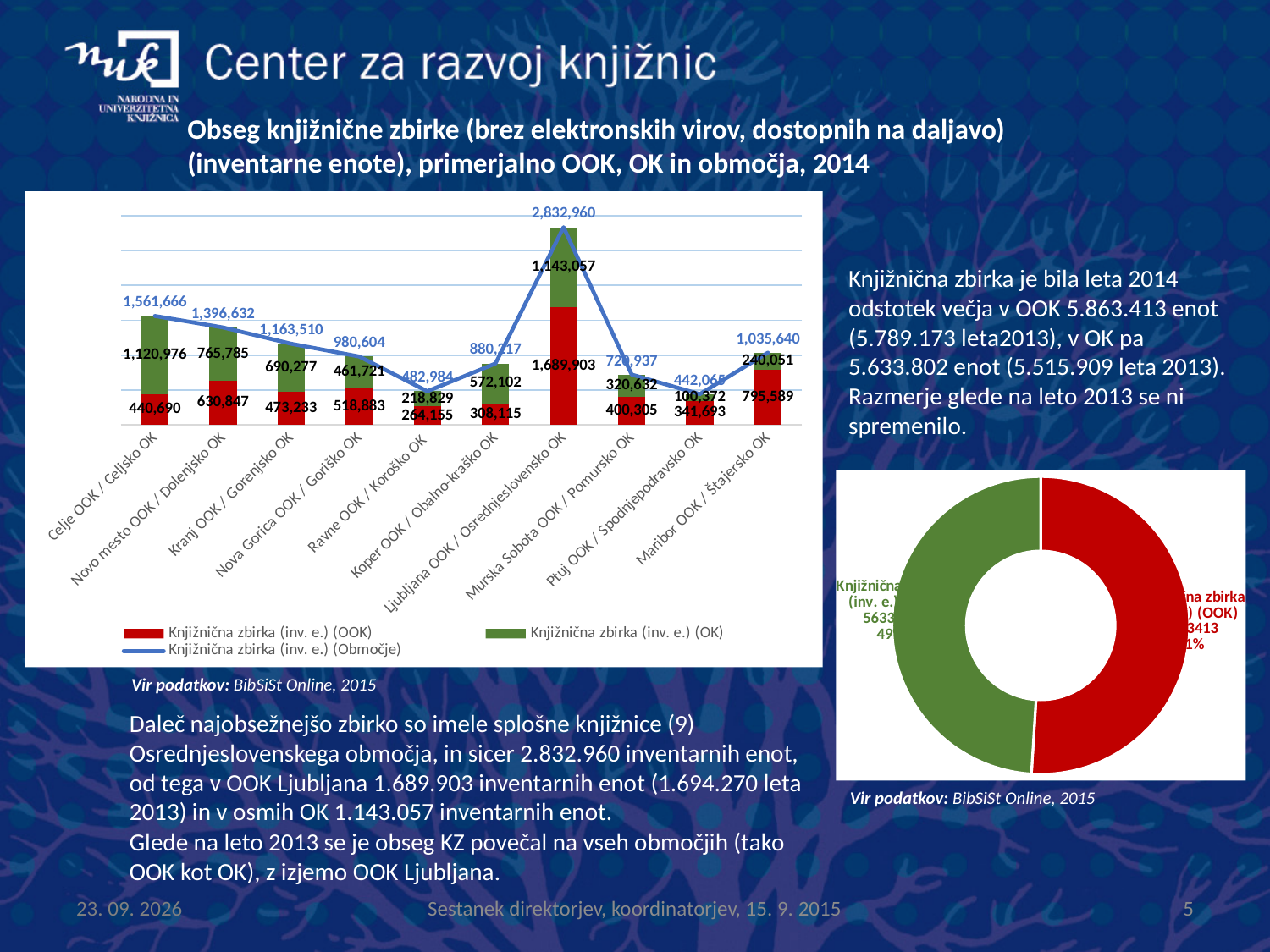
In the left bar chart, how many categories (OOK / OK pairs) are shown on the x axis? 10 In the left bar chart, which category has the lowest value for Knjižnična zbirka (inv. e.) (OK)? Ptuj OOK / Spodnjepodravsko OK In the left bar chart, what is the difference between the OOK value and the OK value for Ljubljana OOK / Osrednjeslovensko OK? 546,846 In the left bar chart, what is the value of Knjižnična zbirka (inv. e.) (OK) for Celje OOK / Celjsko OK? 1,120,976 In the left bar chart, what is the total of the stacked bar (OOK plus OK) for Celje OOK / Celjsko OK? 1,561,666 In the left bar chart, what is the value of Knjižnična zbirka (inv. e.) (OOK) for Maribor OOK / Štajersko OK? 795,589 In the left bar chart, what is the value of Knjižnična zbirka (inv. e.) (OOK) for Ljubljana OOK / Osrednjeslovensko OK? 1,689,903 In the left bar chart, which category has the highest value for Knjižnična zbirka (inv. e.) (Območje)? Ljubljana OOK / Osrednjeslovensko OK What kind of chart is the large chart on the left of the slide? bar chart with a line In the left bar chart, how many series does the legend list? 3 In the left bar chart, which has the larger OOK value: Novo mesto OOK / Dolenjsko OK or Kranj OOK / Gorenjsko OK? Novo mesto OOK / Dolenjsko OK What kind of chart is shown on the right side of the slide? doughnut chart